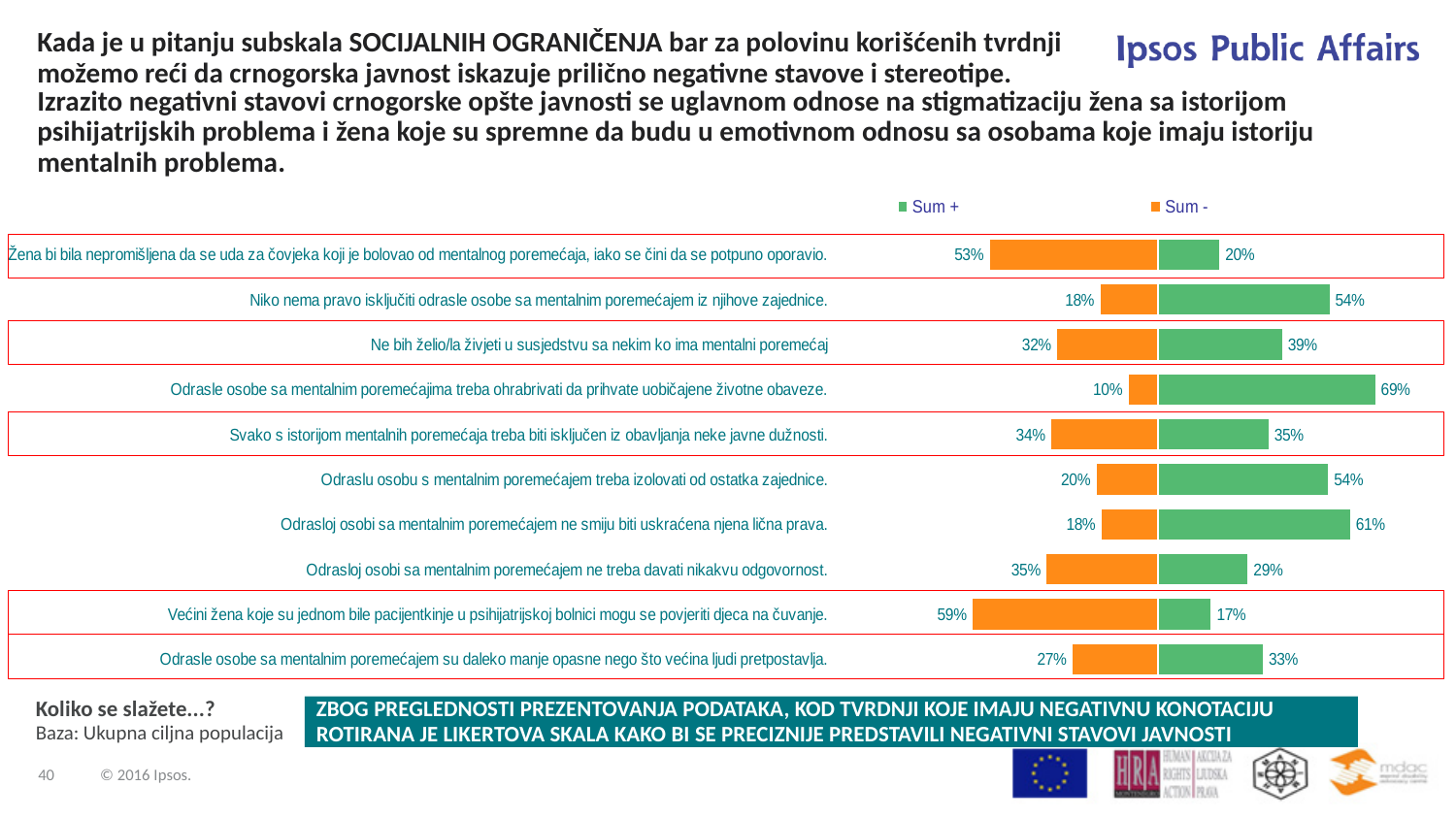
Which statement has the lowest Sum + value? Većini žena koje su jednom bile pacijentkinje u psihijatrijskoj bolnici mogu se povjeriti djeca na čuvanje What is the difference between the Sum - and Sum + values for the statement "Žena bi bila nepromišljena da se uda za čovjeka koji je bolovao od mentalnog poremećaja, iako se čini da se potpuno oporavio"? 33 percentage points What is the Sum + value for the statement "Odrasloj osobi sa mentalnim poremećajem ne smiju biti uskraćena njena lična prava"? 61% What kind of chart is shown on the slide? Bar chart For the statement "Odrasloj osobi sa mentalnim poremećajem ne treba davati nikakvu odgovornost", which is larger, Sum + or Sum -? Sum - Which statement has the lowest Sum - value? Odrasle osobe sa mentalnim poremećajima treba ohrabrivati da prihvate uobičajene životne obaveze What is the Sum + value for the statement "Odrasle osobe sa mentalnim poremećajima treba ohrabrivati da prihvate uobičajene životne obaveze"? 69% What is the Sum - value for the statement "Većini žena koje su jednom bile pacijentkinje u psihijatrijskoj bolnici mogu se povjeriti djeca na čuvanje"? 59% Which statement has the highest Sum + value? Odrasle osobe sa mentalnim poremećajima treba ohrabrivati da prihvate uobičajene životne obaveze How many series does the chart legend list? 2 How many statements (categories) are plotted in the chart? 10 Which colour represents the Sum - series in the chart? Orange